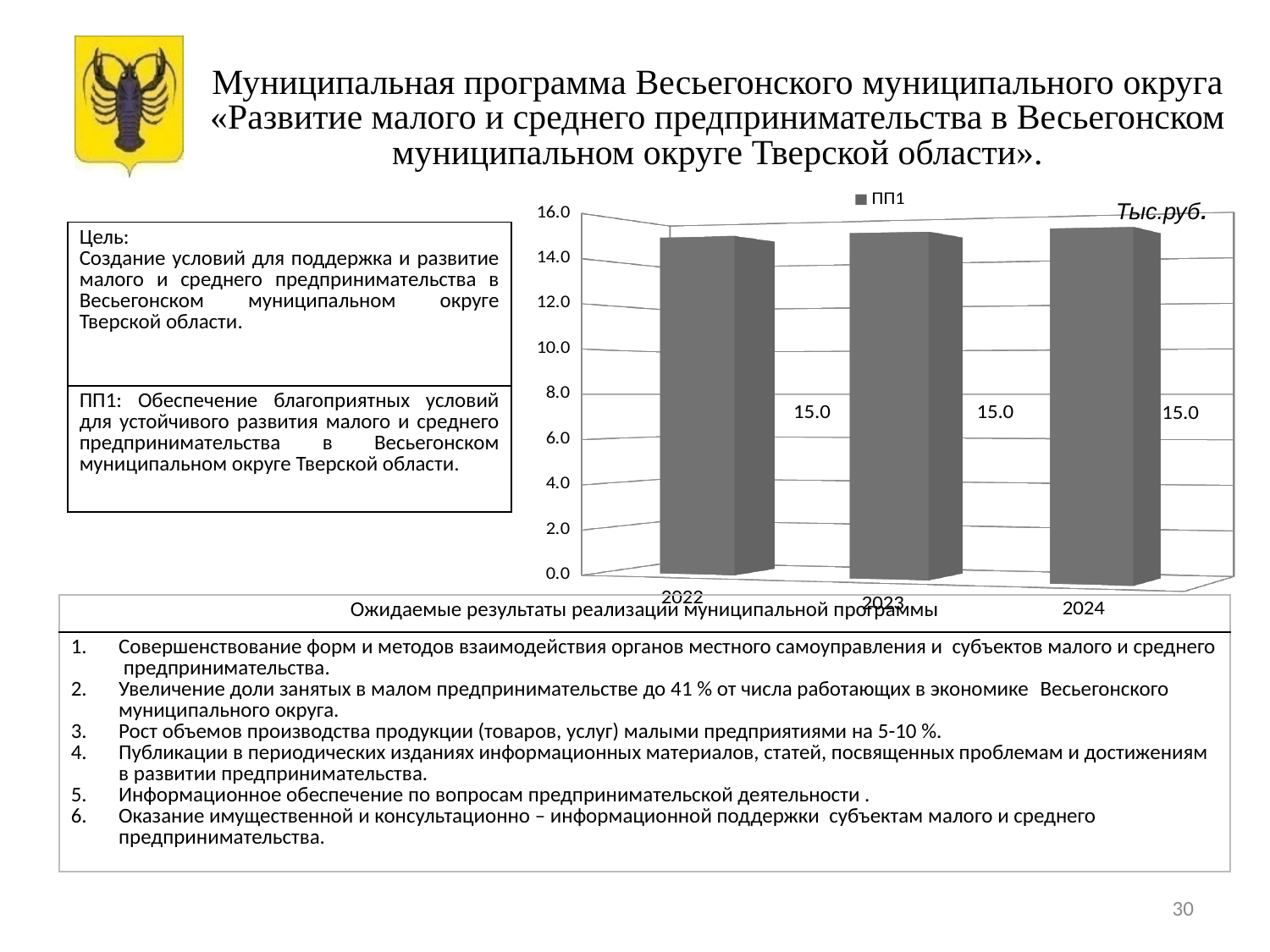
What kind of chart is shown on the slide? bar chart Do the values rise, fall or stay the same from 2022 to 2024? stay the same How many categories (years) are shown on the x axis of the chart? 3 What is the difference between the values for 2024 and 2022? 0.0 Is the value for 2022 greater or less than 16.0? less What is the value for 2024 in the chart? 15.0 What unit label is shown at the top right of the chart? Тыс.руб. What is the name of the series shown in the chart legend? ПП1 What is the value for 2023 in the chart? 15.0 Is the value for 2023 greater or less than 14.0? greater How many series does the chart legend list? 1 What is the value for 2022 in the chart? 15.0